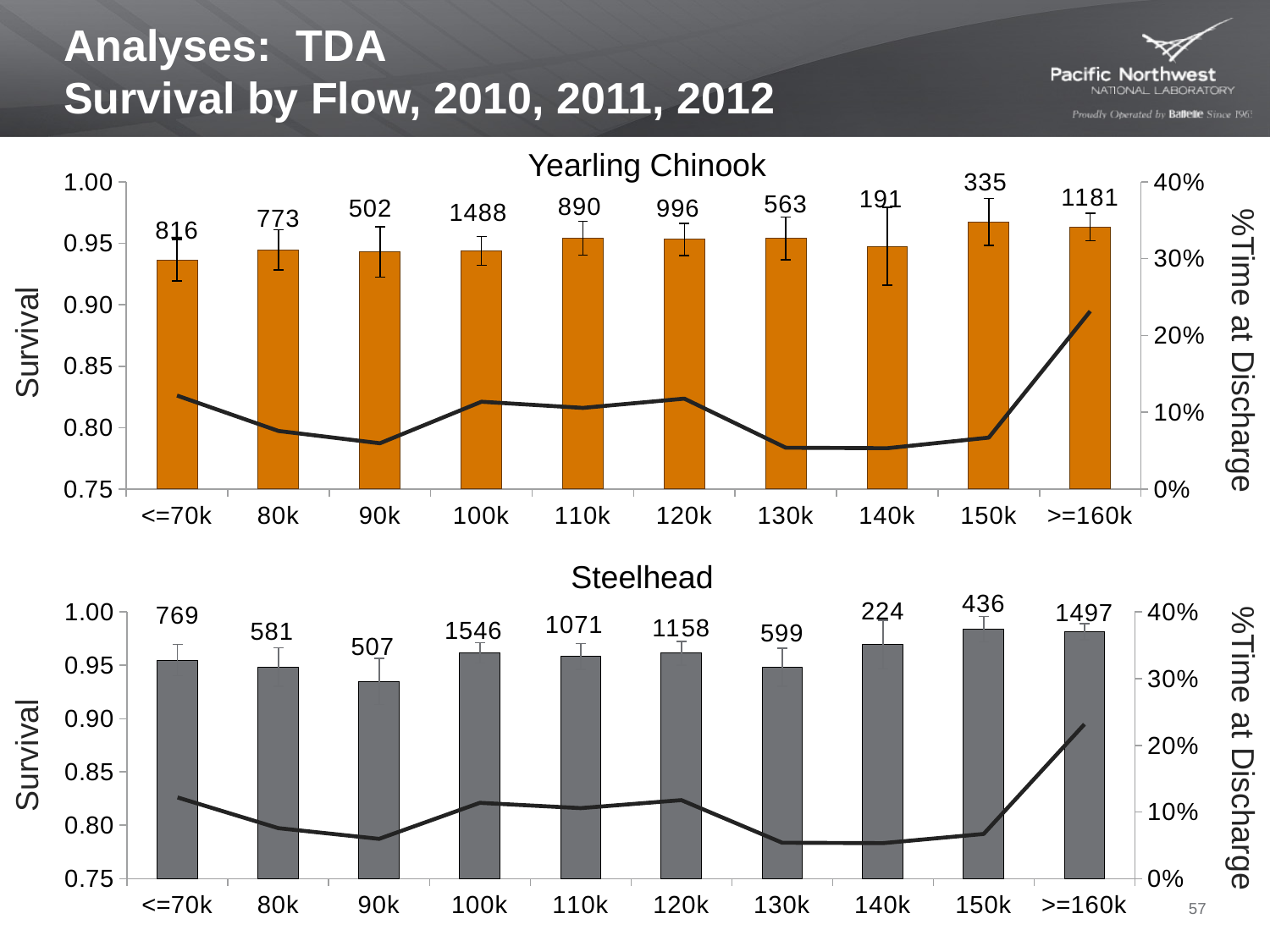
In the Steelhead chart, is the %Time at Discharge line value at >=160k greater or less than 20%? greater In the Steelhead chart, which flow category has the largest number printed above its bar? 100k In the Yearling Chinook chart, what number is printed above the 100k bar? 1488 What is the title of the right-hand vertical axis on the Yearling Chinook chart? %Time at Discharge In the Steelhead chart, is the survival value for 90k greater or less than 0.95? less In the Yearling Chinook chart, which is larger: the number printed above the 100k bar or the number above the 110k bar? 100k In the Steelhead chart, which flow category has the lowest survival bar? 90k In the Yearling Chinook chart, which flow category has the smallest number printed above its bar? 140k In the Steelhead chart, what is the difference between the numbers printed above the 100k and >=160k bars? 49 How many flow categories are shown on the x axis of the Steelhead chart? 10 In the Steelhead chart, what number is printed above the >=160k bar? 1497 In the Yearling Chinook chart, is the survival value for 150k greater or less than 0.95? greater